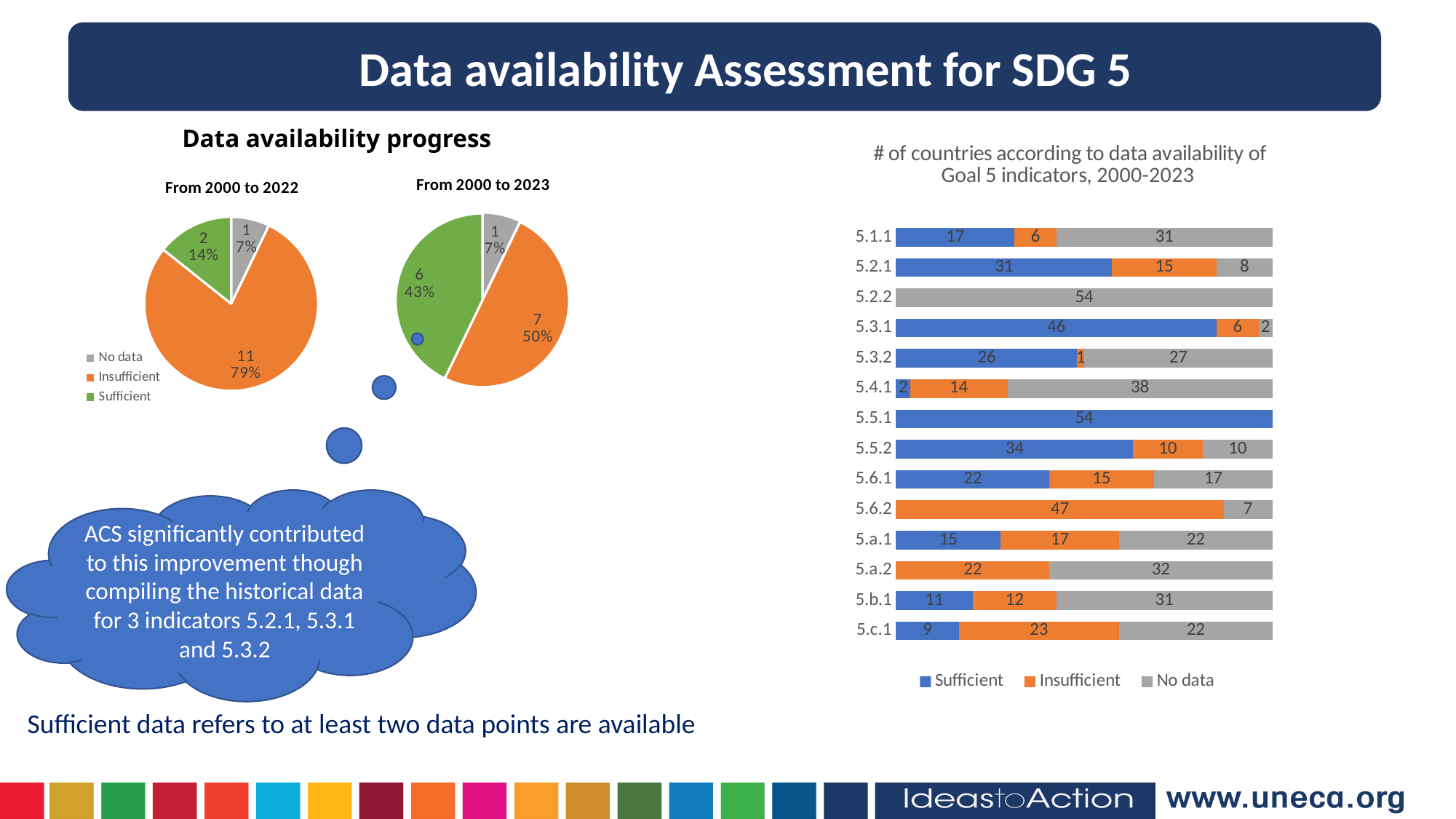
In the '# of countries according to data availability of Goal 5 indicators, 2000-2023' chart, how many indicators are listed? 14 What type of chart is the '# of countries according to data availability of Goal 5 indicators, 2000-2023' chart? Stacked bar chart In the 'From 2000 to 2022' pie chart, which category has the largest slice? Insufficient In the '# of countries according to data availability of Goal 5 indicators, 2000-2023' chart, what is the difference between the number of countries with insufficient data for 5.c.1 and for 5.b.1? 11 In the 'From 2000 to 2022' pie chart, what share of indicators had insufficient data? 79% In the '# of countries according to data availability of Goal 5 indicators, 2000-2023' chart, how many countries have sufficient data for indicator 5.3.1? 46 In the '# of countries according to data availability of Goal 5 indicators, 2000-2023' chart, how many countries have no data for indicator 5.4.1? 38 In the '# of countries according to data availability of Goal 5 indicators, 2000-2023' chart, what is the total number of countries for indicator 5.6.1? 54 In the '# of countries according to data availability of Goal 5 indicators, 2000-2023' chart, which indicator has the highest number of countries with sufficient data? 5.5.1 In the 'From 2000 to 2023' pie chart, which category has the smallest slice? No data In the 'From 2000 to 2023' pie chart, what share of indicators had sufficient data? 43% In the 'From 2000 to 2023' pie chart, how many indicators are in the Insufficient category? 7